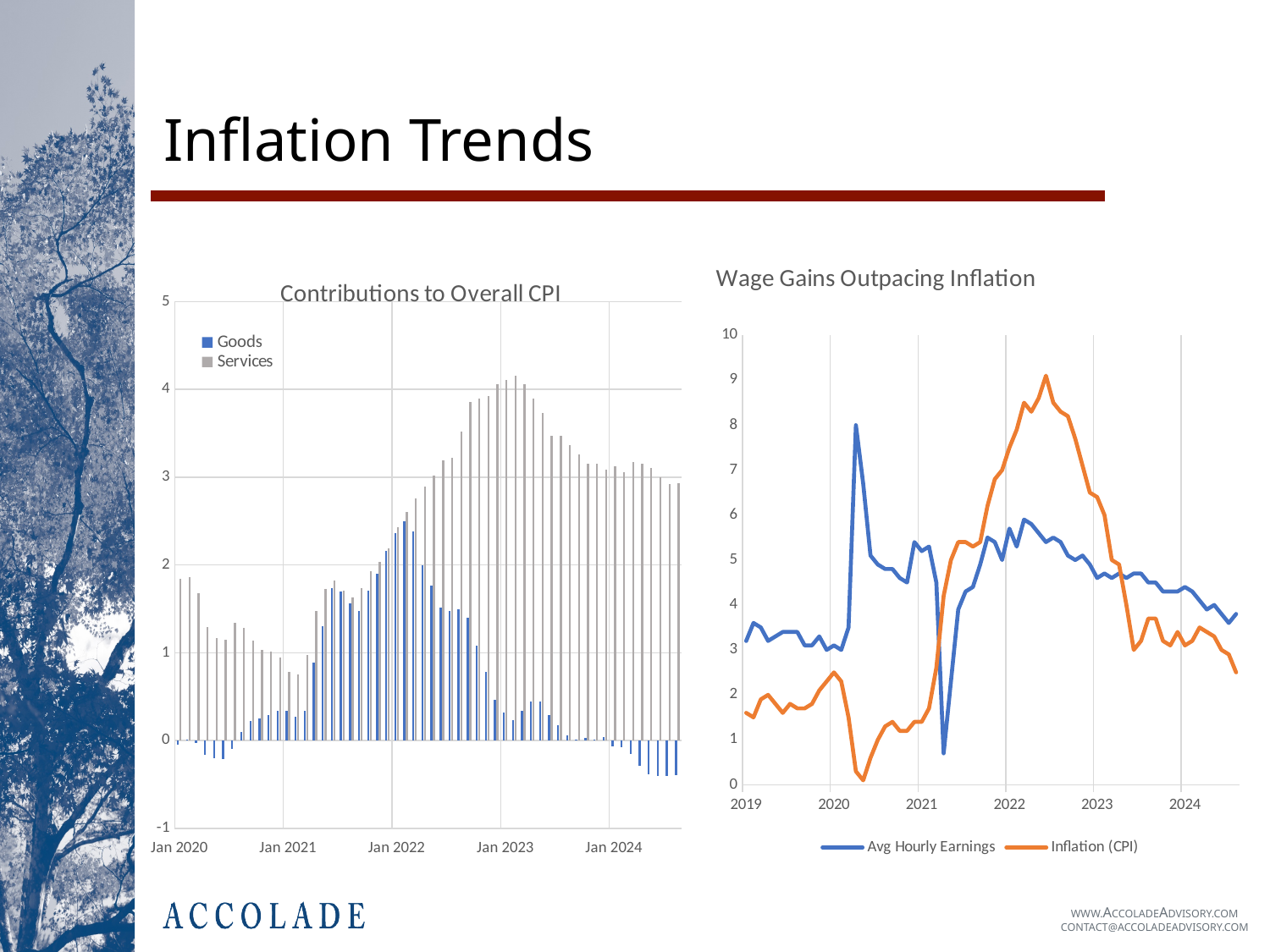
What kind of chart is the "Wage Gains Outpacing Inflation" chart? line chart In the "Wage Gains Outpacing Inflation" chart, which two series are shown in the legend? Avg Hourly Earnings and Inflation (CPI) In the "Wage Gains Outpacing Inflation" chart, does Inflation (CPI) rise or fall from its 2022 peak to 2024? fall In the "Contributions to Overall CPI" chart, is the Goods value at Jan 2022 greater or less than 2? greater In the "Contributions to Overall CPI" chart, which series is shown in blue? Goods In the "Wage Gains Outpacing Inflation" chart, is the Inflation (CPI) value at the start of 2019 greater or less than 2? less In the "Contributions to Overall CPI" chart, is the Goods value at Jan 2024 greater or less than 0? less What kind of chart is the "Contributions to Overall CPI" chart? bar chart In the "Contributions to Overall CPI" chart, which series is larger at Jan 2023, Goods or Services? Services In the "Wage Gains Outpacing Inflation" chart, which series is higher in mid-2022, Avg Hourly Earnings or Inflation (CPI)? Inflation (CPI) How many series does the legend of the "Contributions to Overall CPI" chart list? 2